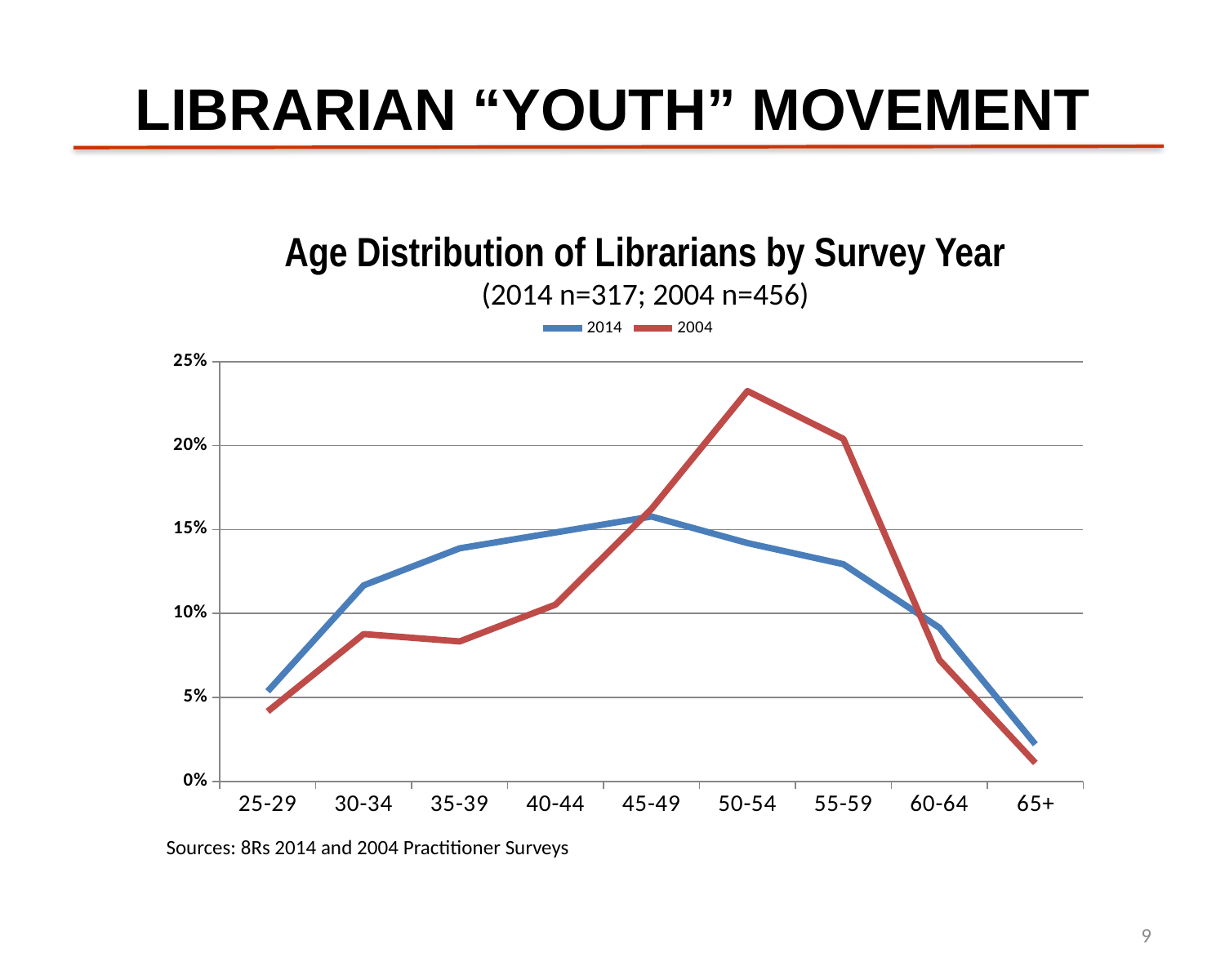
What kind of chart is shown on the slide? Line chart For the 50-54 age group, which series has the larger value, 2014 or 2004? 2004 How many age groups are shown on the x axis? 9 What is the title of the chart? Age Distribution of Librarians by Survey Year Which age group has the highest value for the 2014 series? 45-49 How many series does the legend list? 2 Which age group has the highest value for the 2004 series? 50-54 Which age group has the lowest value for the 2014 series? 65+ For the 35-39 age group, which series has the larger value, 2014 or 2004? 2014 Is the value for the 2014 series at 25-29 greater or less than 10%? less Is the value for the 2004 series at 50-54 greater or less than 20%? greater Which age group has the lowest value for the 2004 series? 65+